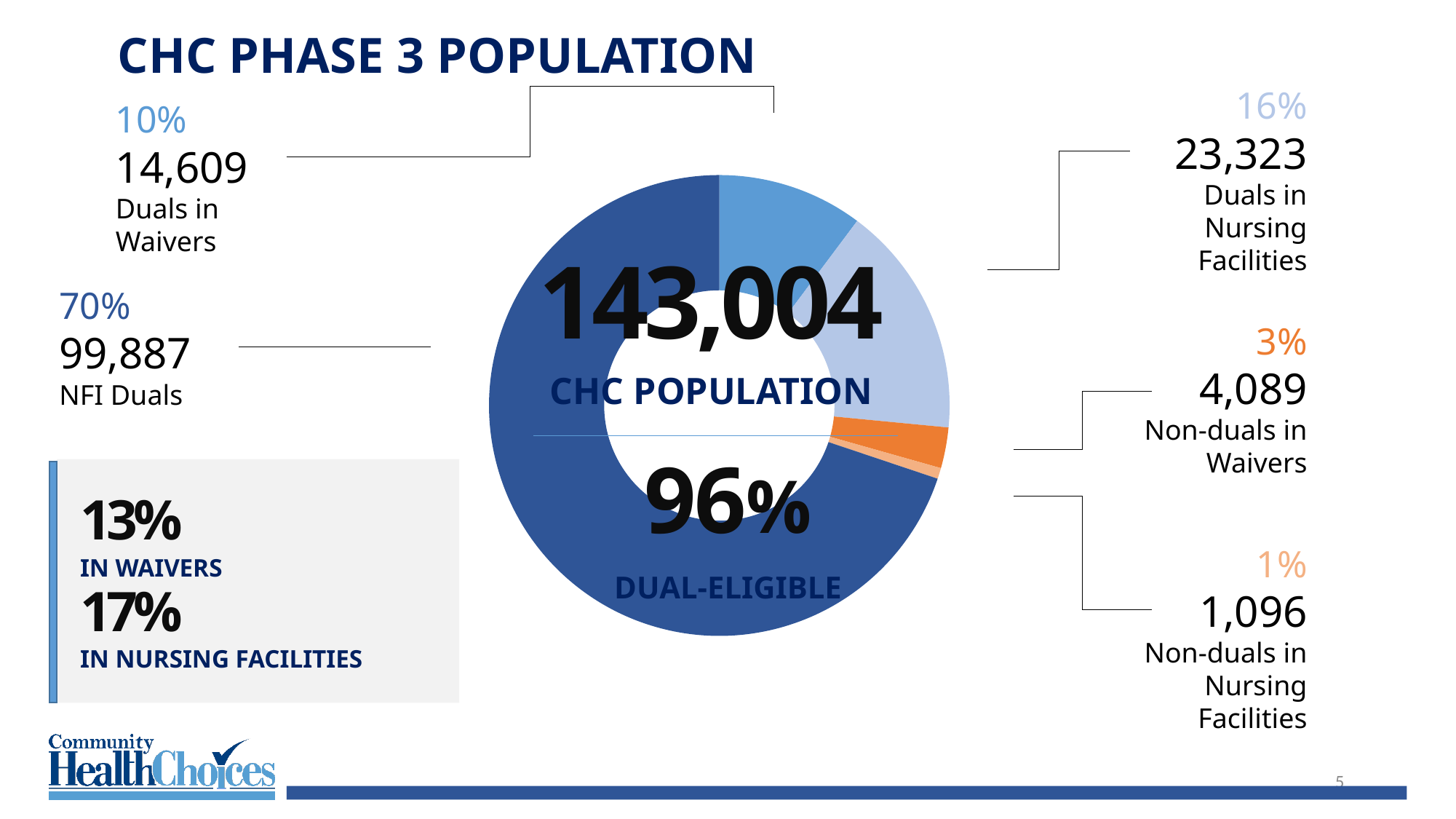
Which segment of the chart is the largest? NFI Duals How many NFI Duals are there? 99,887 What share of the CHC population are NFI Duals? 70% What kind of chart is shown on the slide? Pie chart (donut) How many segments does the donut chart have? 5 What percentage of the CHC population is dual-eligible? 96% What is the total CHC population shown in the centre of the chart? 143,004 Which segment of the chart is the smallest? Non-duals in Nursing Facilities What is the difference between the number of Duals in Nursing Facilities and Duals in Waivers? 8,714 Which is larger: Non-duals in Waivers or Non-duals in Nursing Facilities? Non-duals in Waivers How many Duals in Nursing Facilities are there? 23,323 What share of the CHC population are Non-duals in Waivers? 3%